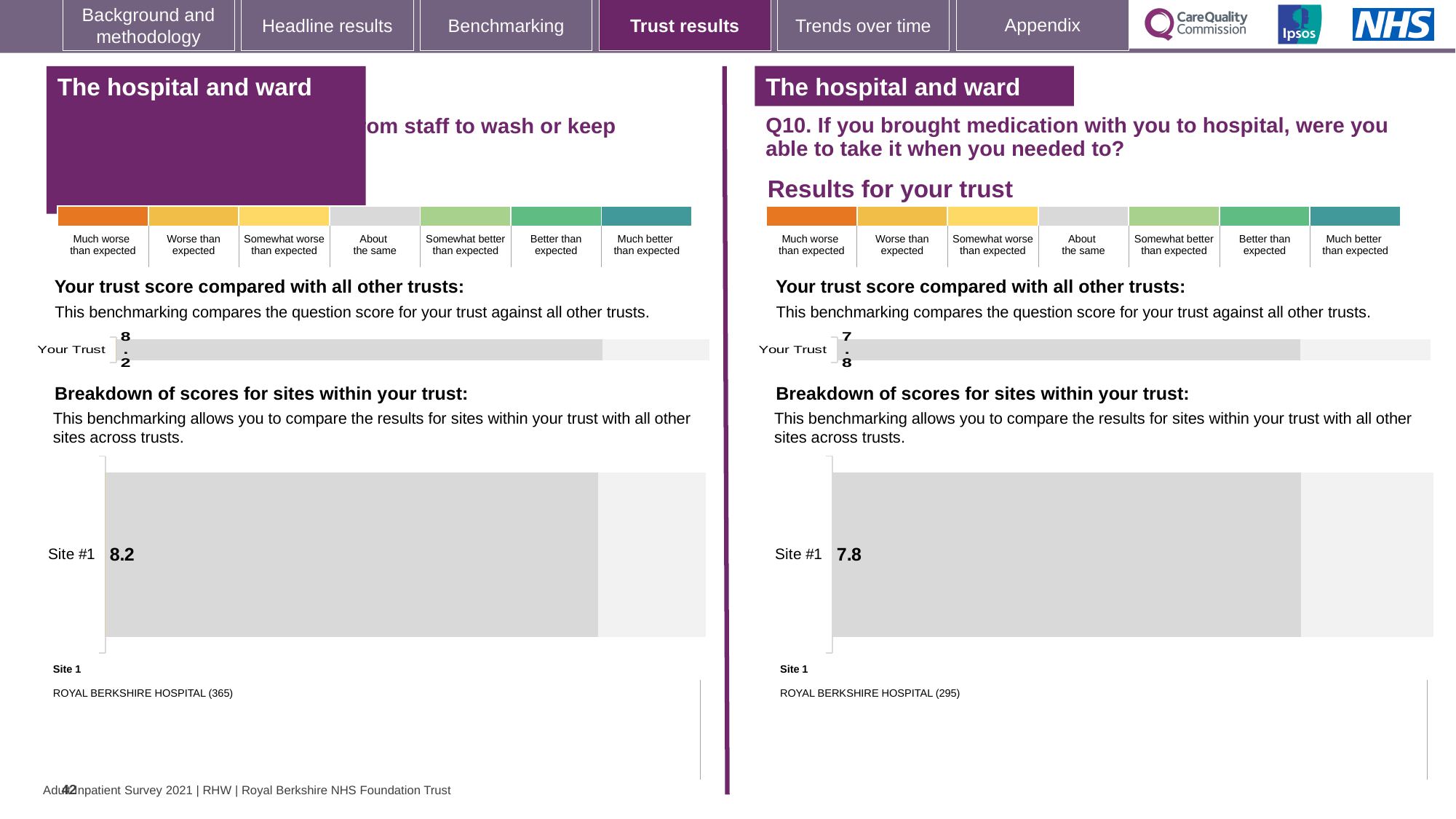
What type of chart is used to show the Site #1 score on the right-hand side of the slide (Q10)? Bar chart On the left-hand side of the slide, what is the score shown for Your Trust in the 'Your trust score compared with all other trusts' chart? 8.2 What is the difference between the Site #1 score on the left-hand side of the slide and the Site #1 score on the right-hand side (Q10)? 0.4 On the left-hand side of the slide, what score is shown for Site #1 in the 'Breakdown of scores for sites within your trust' chart? 8.2 On the right-hand side of the slide (Q10, medication), what is the score shown for Your Trust in the 'Your trust score compared with all other trusts' chart? 7.8 Which is larger: the Your Trust score on the left-hand side of the slide or the Your Trust score on the right-hand side (Q10)? Left-hand side (8.2) How many sites are shown in the 'Breakdown of scores for sites within your trust' chart on the left-hand side of the slide? 1 On the right-hand side of the slide (Q10), what score is shown for Site #1 in the 'Breakdown of scores for sites within your trust' chart? 7.8 Which site is listed as Site 1 beneath the breakdown chart on the right-hand side of the slide (Q10)? ROYAL BERKSHIRE HOSPITAL (295) How many sites are shown in the 'Breakdown of scores for sites within your trust' chart on the right-hand side of the slide (Q10)? 1 How many categories does the colour key above the charts on the right-hand side of the slide (Q10) contain? 7 Is the Site #1 score on the left-hand side of the slide the same as the Your Trust score on the left-hand side? Yes, both are 8.2